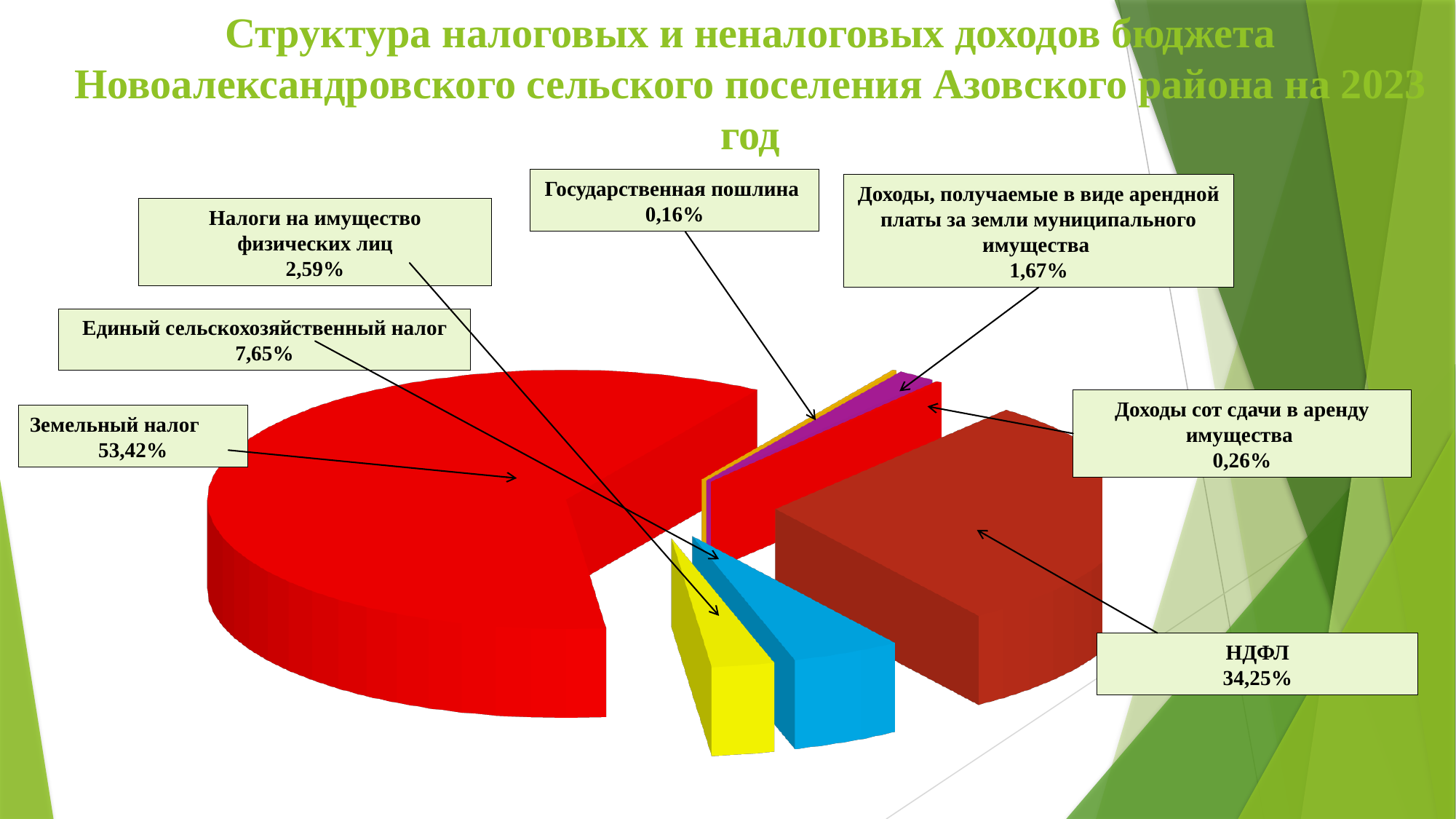
What type of chart is shown on the slide? Pie chart Which category has the smallest share of the pie? Государственная пошлина What is the difference in percentage points between Земельный налог and НДФЛ? 19,17 What is the value for Государственная пошлина? 0,16% What share is shown for Налоги на имущество физических лиц? 2,59% What is the value shown for НДФЛ? 34,25% Which category has the largest share of the pie? Земельный налог What percentage is shown for Единый сельскохозяйственный налог? 7,65% Which is larger: Единый сельскохозяйственный налог or Налоги на имущество физических лиц? Единый сельскохозяйственный налог How many categories are shown in the pie chart? 7 What share of the budget revenue does Земельный налог account for? 53,42% What is the value shown for Доходы сот сдачи в аренду имущества? 0,26%